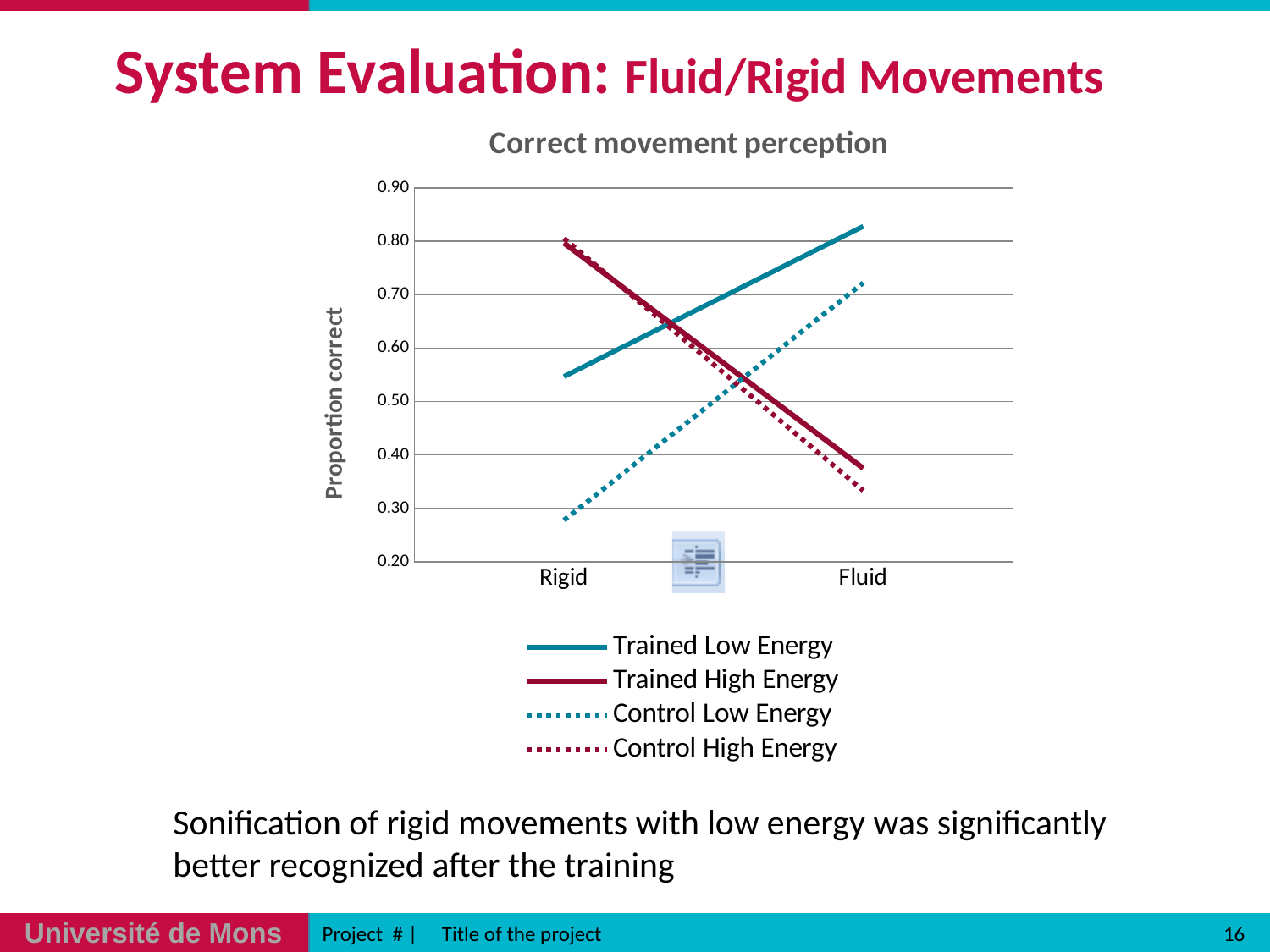
Is the value for Trained Low Energy at Rigid greater or less than 0.50? greater Is the value for Control High Energy at Fluid greater or less than 0.40? less How many categories are shown on the x axis? 2 Which series has the highest value at Fluid? Trained Low Energy How many series does the legend list? 4 What kind of chart is shown on the slide? line chart Which series has the lowest value at Rigid? Control Low Energy Does the Trained Low Energy line rise or fall from Rigid to Fluid? rise Does the Trained High Energy line rise or fall from Rigid to Fluid? fall At Fluid, which is larger: Trained Low Energy or Control Low Energy? Trained Low Energy What is the label of the vertical axis? Proportion correct What is the title of the chart? Correct movement perception